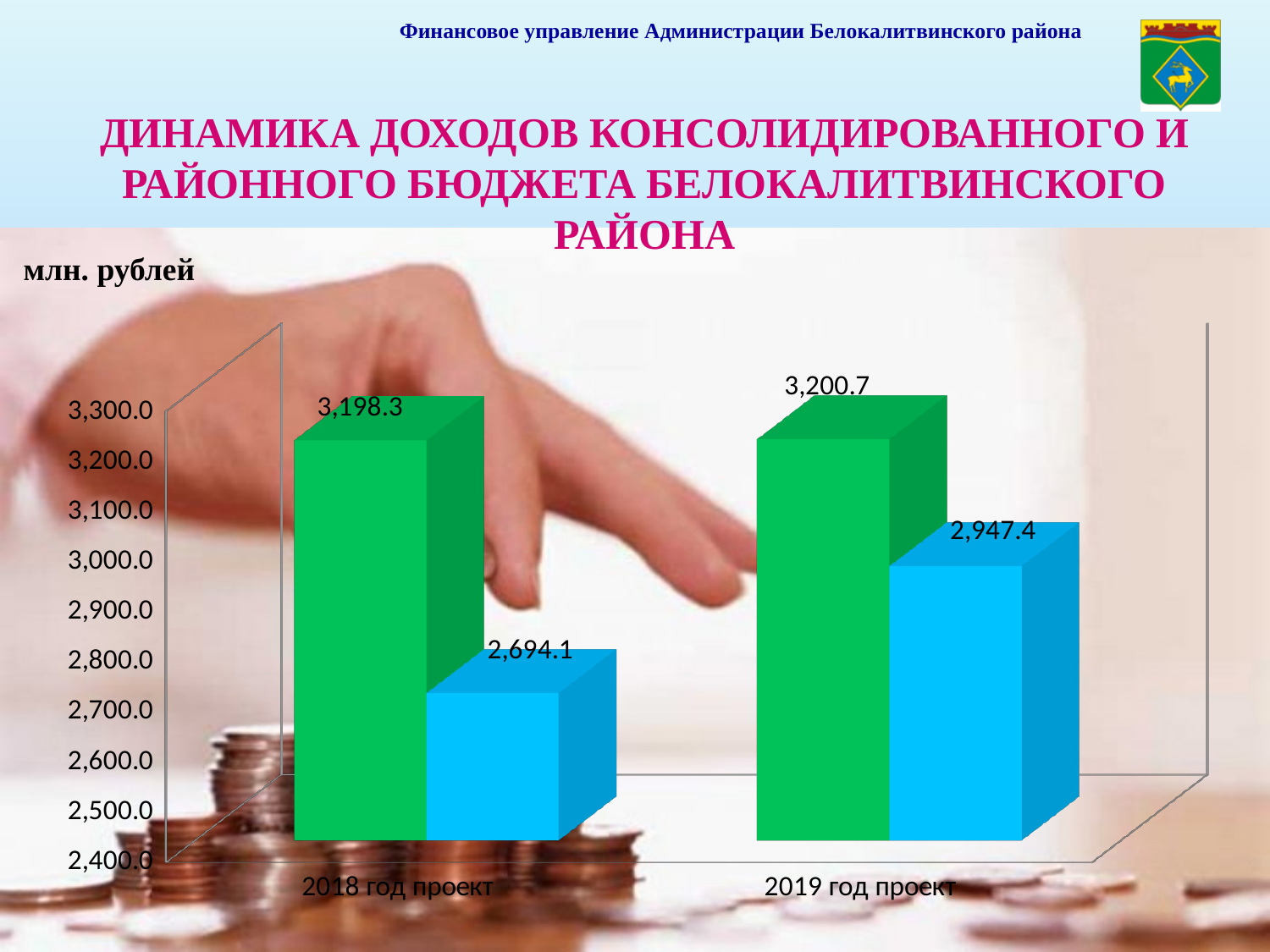
How many categories are shown on the x axis of the chart? 2 Which bar on the chart has the lowest value? Blue bar for 2018 год проект (2,694.1) What is the difference between the green and blue bars for 2019 год проект? 253.3 Which bar on the chart has the highest value? Green bar for 2019 год проект (3,200.7) What is the difference between the green and blue bars for 2018 год проект? 504.2 Which is larger: the blue bar for 2018 год проект or the blue bar for 2019 год проект? 2019 год проект What unit of measurement is indicated for the chart values? млн. рублей What is the value of the blue bar for 2019 год проект? 2,947.4 What is the value of the green bar for 2018 год проект? 3,198.3 What is the value of the blue bar for 2018 год проект? 2,694.1 What is the value of the green bar for 2019 год проект? 3,200.7 Do the blue bar values rise or fall from 2018 год проект to 2019 год проект? Rise